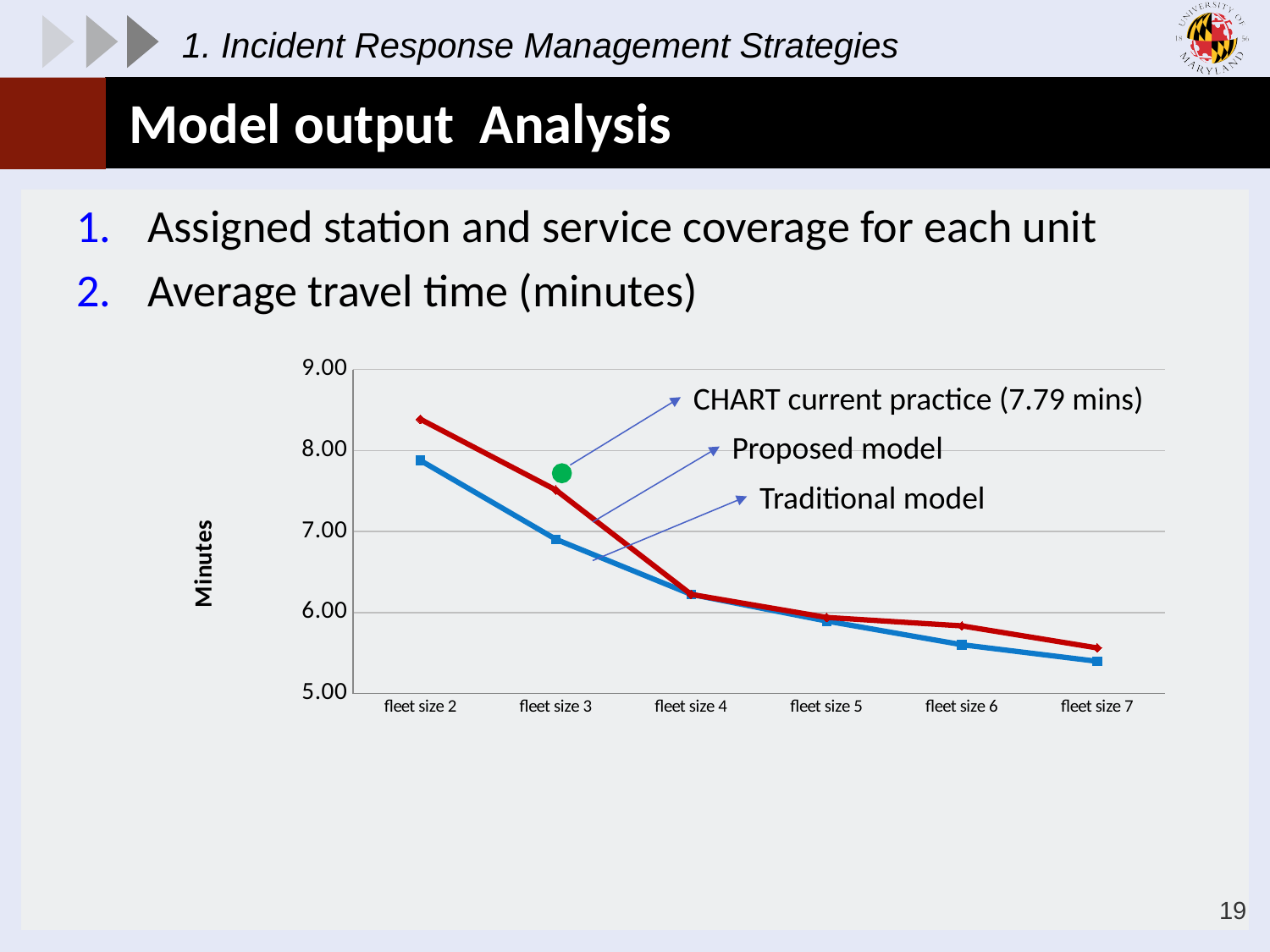
What value is given for the CHART current practice in the chart annotation? 7.79 mins Is the value for the Traditional model at fleet size 7 greater or less than 6.00? less What is the label of the y axis of the chart? Minutes Is the value for the Proposed model at fleet size 3 greater or less than 7.00? greater Do the values for the Proposed model rise or fall as fleet size increases from 2 to 7? fall At which fleet size is the Proposed model value lowest? fleet size 7 How many model lines are plotted in the chart? 2 What kind of chart is shown on the slide? line chart Is the value for the Proposed model at fleet size 2 greater or less than 8.00? greater At fleet size 2, which model has the higher average travel time, the Proposed model or the Traditional model? Proposed model How many fleet size categories are shown on the x axis of the chart? 6 At which fleet size is the Traditional model value highest? fleet size 2